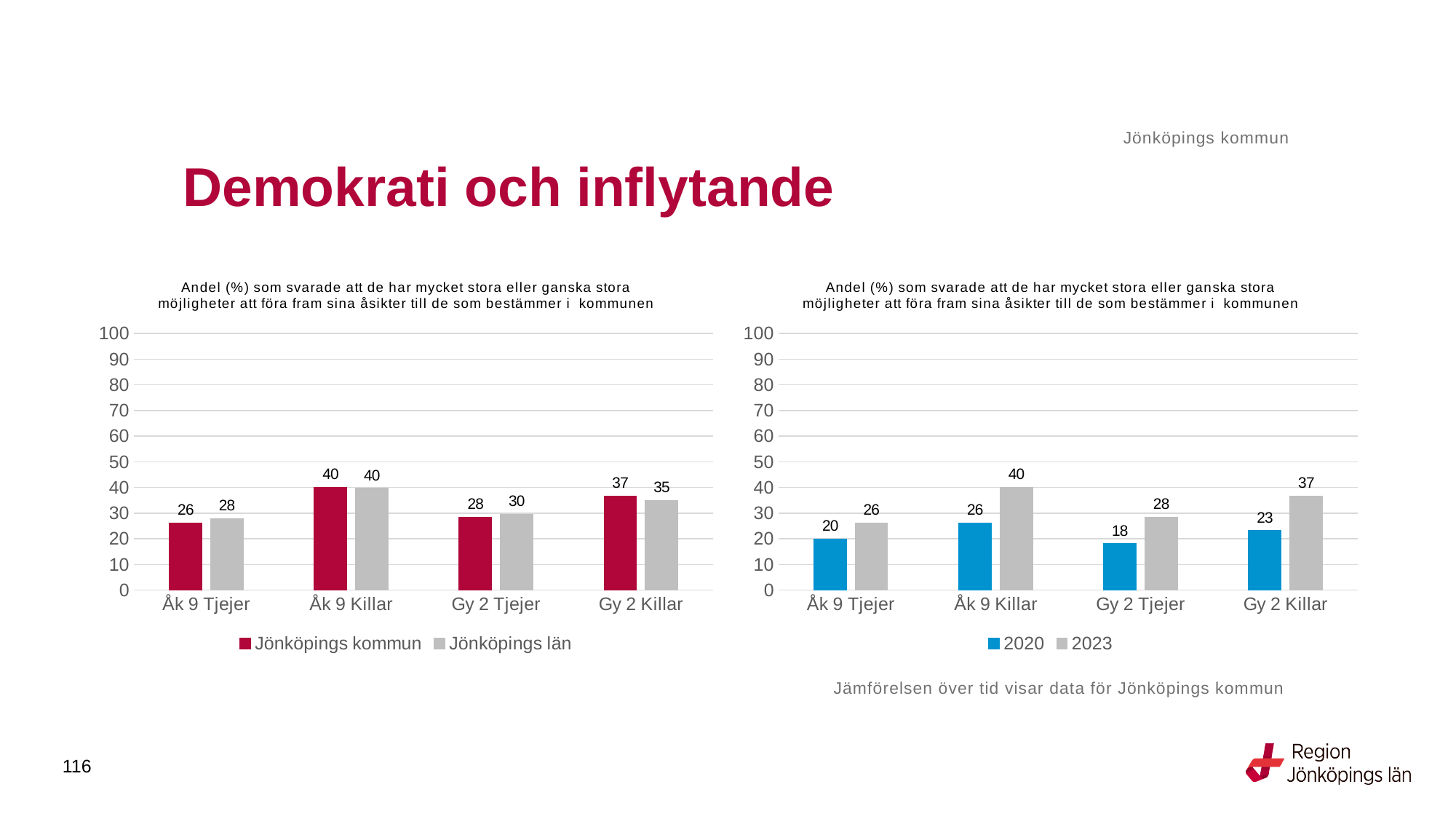
In the left chart, which is larger for Gy 2 Killar: Jönköpings kommun or Jönköpings län? Jönköpings kommun In the right chart, which category has the highest 2023 value? Åk 9 Killar In the right chart, how many series does the legend list? 2 In the right chart, what is the 2023 value for Åk 9 Killar? 40 In the left chart, what is the value for Jönköpings kommun for Åk 9 Killar? 40 In the left chart, what is the value for Jönköpings län for Gy 2 Killar? 35 In the left chart, what is the difference between Jönköpings kommun and Jönköpings län for Gy 2 Tjejer? 2 How many categories are shown on the x axis of the left chart? 4 In the right chart, what is the difference between the 2023 and 2020 values for Gy 2 Killar? 14 In the left chart, which category has the lowest value for Jönköpings kommun? Åk 9 Tjejer What kind of chart is the right chart? Bar chart In the right chart, what is the 2020 value for Gy 2 Tjejer? 18